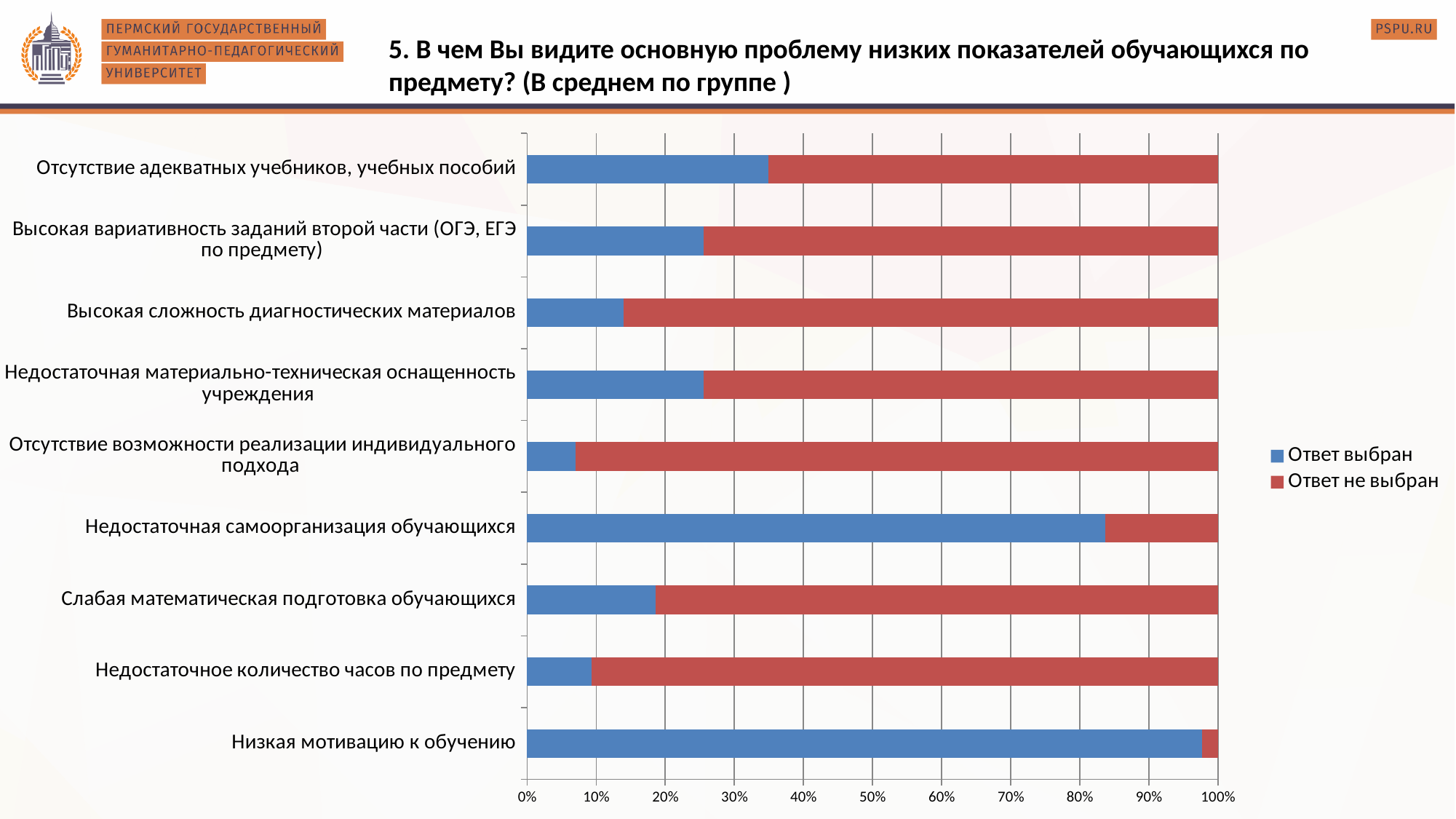
Which category has the lowest share of "Ответ выбран"? Отсутствие возможности реализации индивидуального подхода What are the two legend entries of the chart? Ответ выбран; Ответ не выбран Is the "Ответ выбран" value for "Низкая мотивацию к обучению" greater or less than 90%? greater What kind of chart is shown on the slide? stacked bar chart How many series does the legend list? 2 Which colour represents the series "Ответ не выбран"? red Which category has the highest share of "Ответ выбран"? Низкая мотивацию к обучению Is the "Ответ выбран" value for "Высокая сложность диагностических материалов" greater or less than 20%? less How many categories (answer options) are plotted on the chart? 9 Which has a larger "Ответ выбран" share: "Слабая математическая подготовка обучающихся" or "Отсутствие адекватных учебников, учебных пособий"? Отсутствие адекватных учебников, учебных пособий Is the "Ответ выбран" value for "Недостаточная самоорганизация обучающихся" greater or less than 80%? greater